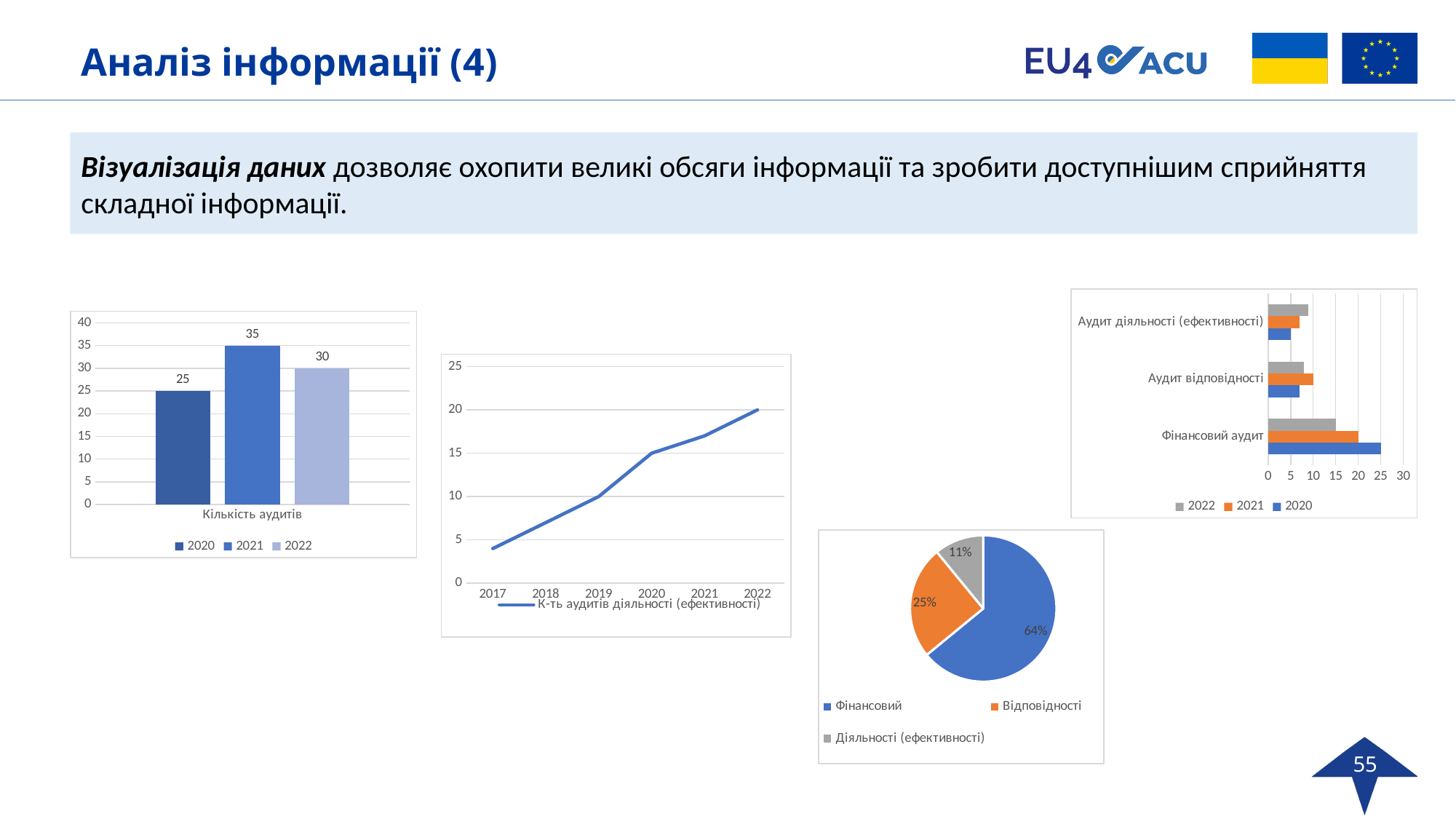
What kind of chart is the middle chart (К-ть аудитів діяльності (ефективності))? line chart In the horizontal bar chart at the top right, is the 2020 value for Аудит відповідності greater or less than 10? less In the horizontal bar chart at the top right, which category has the highest value for 2020? Фінансовий аудит In the bar chart on the left (Кількість аудитів), what is the difference between the 2021 and 2022 values? 5 In the middle line chart (К-ть аудитів діяльності (ефективності)), is the value for 2017 greater or less than 5? less In the bar chart on the left (Кількість аудитів), what is the value for 2021? 35 In the middle line chart (К-ть аудитів діяльності (ефективності)), how many years are plotted on the x axis? 6 In the middle line chart (К-ть аудитів діяльності (ефективності)), what is the value for 2022? 20 In the pie chart at the bottom right, what share does the Відповідності slice have? 25% In the bar chart on the left (Кількість аудитів), how many series does the legend list? 3 In the middle line chart (К-ть аудитів діяльності (ефективності)), do the values rise or fall from 2017 to 2022? rise In the bar chart on the left (Кількість аудитів), which year has the lowest value? 2020